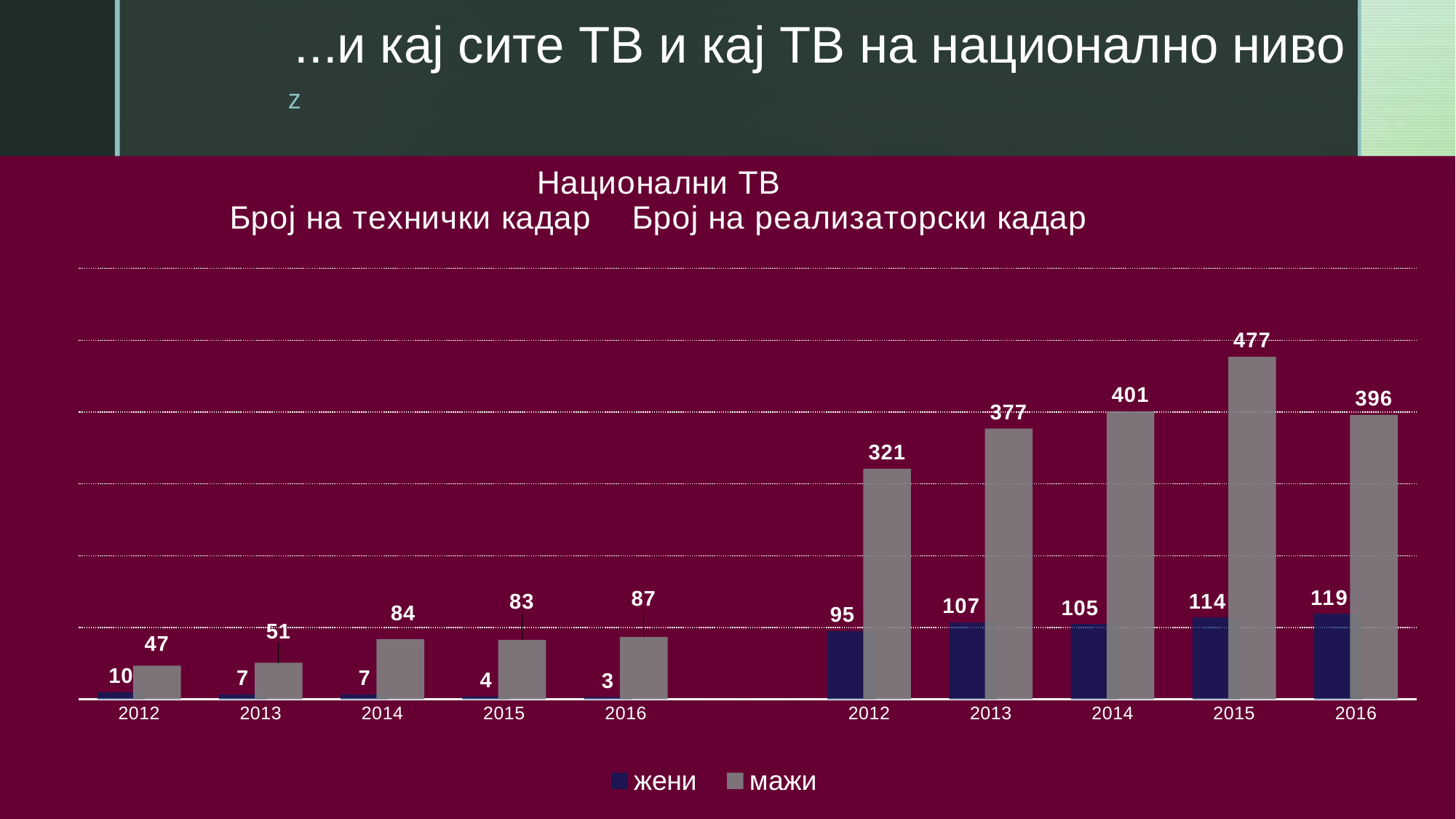
How many series does the legend list? 2 In the Број на технички кадар group, is the value for мажи larger in 2013 or in 2014? 2014 What is the value for мажи in 2014 in the Број на технички кадар group? 84 Which colour represents the series мажи in the legend? Grey What kind of chart is shown on the slide? Bar chart In the Број на реализаторски кадар group, which year has the highest value for мажи? 2015 In the Број на реализаторски кадар group, do the values for жени generally rise or fall from 2012 to 2016? Rise What is the title of the chart? Национални ТВ Број на технички кадар Број на реализаторски кадар What is the value for жени in 2016 in the Број на реализаторски кадар group? 119 In the Број на технички кадар group, which year has the lowest value for жени? 2016 In the Број на технички кадар group, do the values for жени rise or fall from 2012 to 2016? Fall What is the difference between мажи and жени in 2012 in the Број на реализаторски кадар group? 226